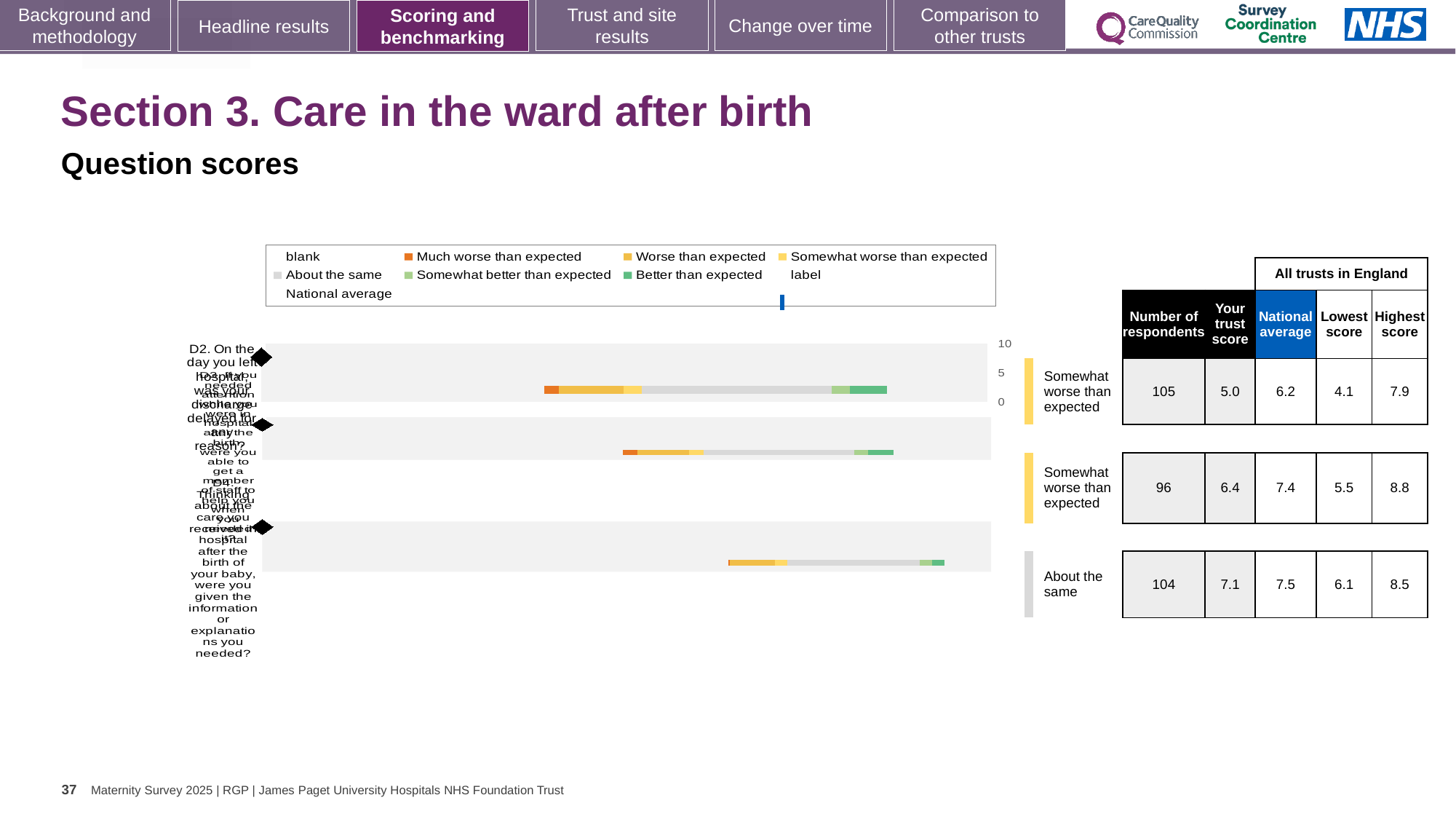
What is the benchmark rating shown beside the first (top) bar? Somewhat worse than expected What is the national average for the second (middle) question bar? 7.4 What is the trust score for the first (top) question bar? 5.0 How many question bars are plotted in the chart? 3 How many respondents answered the second (middle) question? 96 What kind of chart is shown on the slide? Bar chart Which question bar has the highest trust score: the first, second or third? Third What is the benchmark rating shown beside the third (bottom) bar? About the same Which legend entry is shown in orange? Much worse than expected What is the difference between the national average and the trust score for the first (top) question bar? 1.2 What is the highest value shown on the chart's score axis? 10 What is the highest score across all trusts in England for the third (bottom) question bar? 8.5